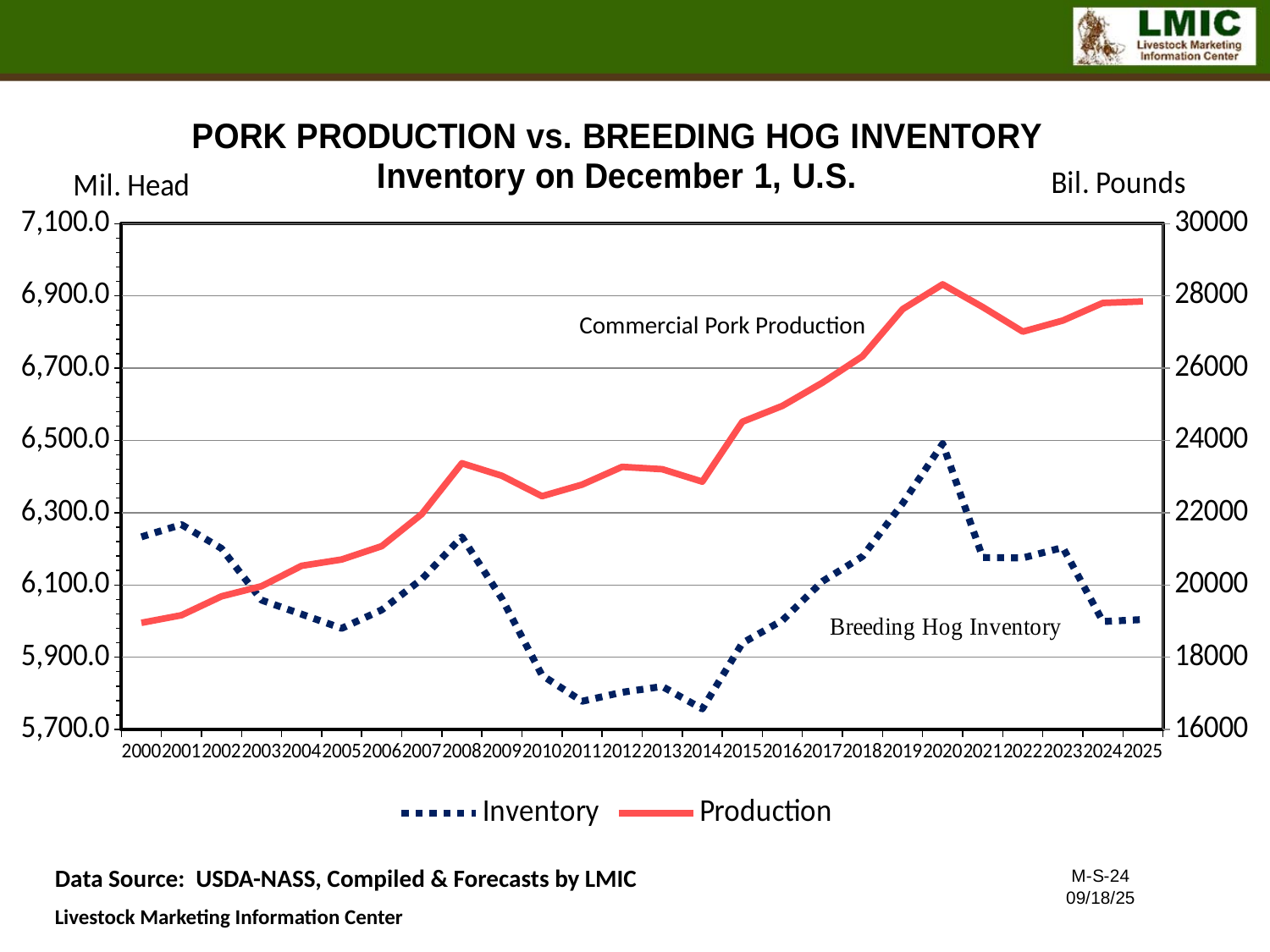
What unit label is shown on the right-hand axis? Bil. Pounds In which year does the Inventory series reach its highest value? 2020 In which year does the Production series reach its highest value? 2020 In which year is the Production series at its lowest value? 2000 How many series does the legend list? 2 Is the Production value for 2008 greater or less than 22000? greater Does the Production series rise or fall from 2014 to 2020? rise Is the Inventory value for 2011 greater or less than 5,900.0? less How many years are plotted along the x axis? 26 Which is larger, the Production value for 2019 or for 2022? 2019 Is the Inventory value for 2001 greater or less than 6,100.0? greater What kind of chart is shown on the slide? line chart